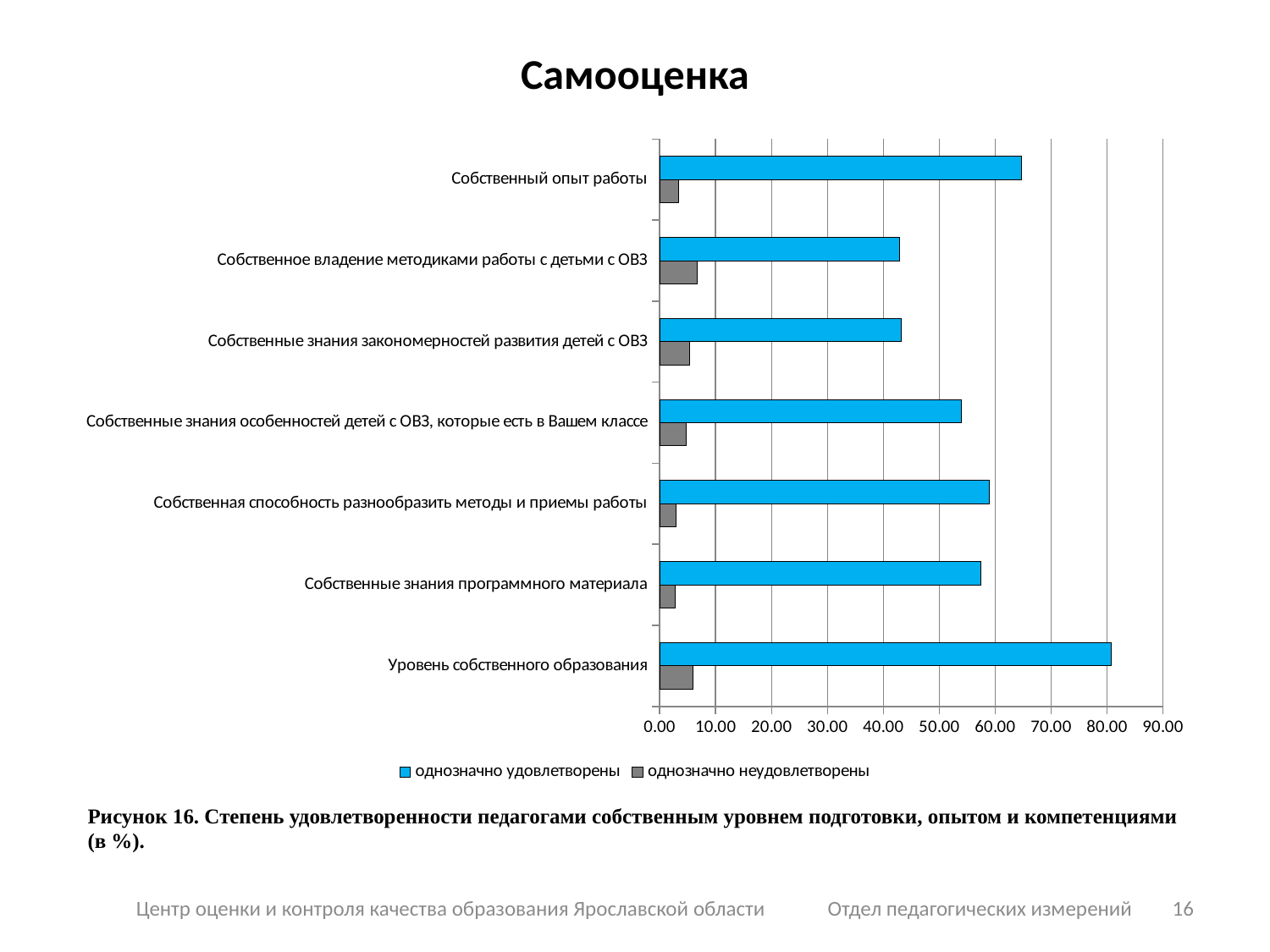
What kind of chart is shown on the slide? bar chart Which category has the highest value for 'однозначно удовлетворены'? Уровень собственного образования How many categories are shown on the chart? 7 Which has the larger 'однозначно удовлетворены' value: 'Собственный опыт работы' or 'Собственное владение методиками работы с детьми с ОВЗ'? Собственный опыт работы What is the title of the slide containing the chart? Самооценка Is the 'однозначно удовлетворены' value for 'Собственное владение методиками работы с детьми с ОВЗ' greater or less than 50.00? less Is the 'однозначно неудовлетворены' value for 'Собственное владение методиками работы с детьми с ОВЗ' greater or less than 10.00? less Is the 'однозначно удовлетворены' value for 'Собственный опыт работы' greater or less than 60.00? greater Which has the larger 'однозначно удовлетворены' value: 'Уровень собственного образования' or 'Собственные знания программного материала'? Уровень собственного образования Which series is shown in blue in the legend? однозначно удовлетворены How many series does the legend list? 2